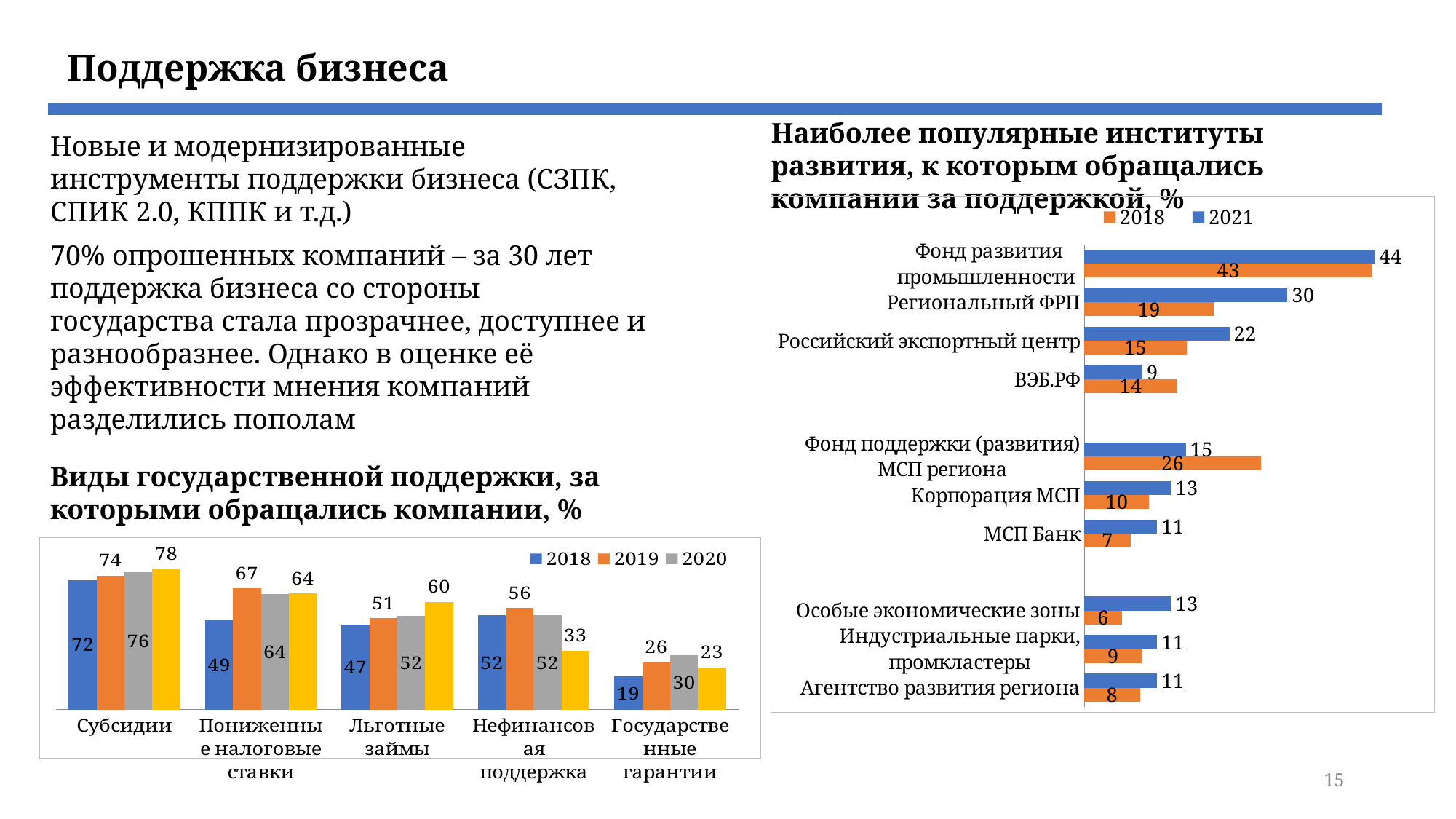
In the chart 'Виды государственной поддержки, за которыми обращались компании, %', which category has the highest value in 2018? Субсидии In the chart 'Виды государственной поддержки, за которыми обращались компании, %', what is the difference between the 2019 and 2018 values for Пониженные налоговые ставки? 18 In the chart 'Наиболее популярные институты развития, к которым обращались компании за поддержкой, %', which institution has the highest value in 2021? Фонд развития промышленности In the chart 'Виды государственной поддержки, за которыми обращались компании, %', what is the value for Субсидии in 2018? 72 In the chart 'Виды государственной поддержки, за которыми обращались компании, %', what is the value for Пониженные налоговые ставки in 2019? 67 In the chart 'Наиболее популярные институты развития, к которым обращались компании за поддержкой, %', which is larger for Фонд поддержки (развития) МСП региона: the 2018 value or the 2021 value? 2018 In the chart 'Наиболее популярные институты развития, к которым обращались компании за поддержкой, %', how many series does the legend list? 2 What kind of chart is 'Наиболее популярные институты развития, к которым обращались компании за поддержкой, %'? Bar chart In the chart 'Наиболее популярные институты развития, к которым обращались компании за поддержкой, %', what is the value for ВЭБ.РФ in 2018? 14 In the chart 'Виды государственной поддержки, за которыми обращались компании, %', how many categories are shown on the x axis? 5 In the chart 'Виды государственной поддержки, за которыми обращались компании, %', what is the value for Государственные гарантии in 2020? 30 In the chart 'Наиболее популярные институты развития, к которым обращались компании за поддержкой, %', what is the value for Региональный ФРП in 2021? 30